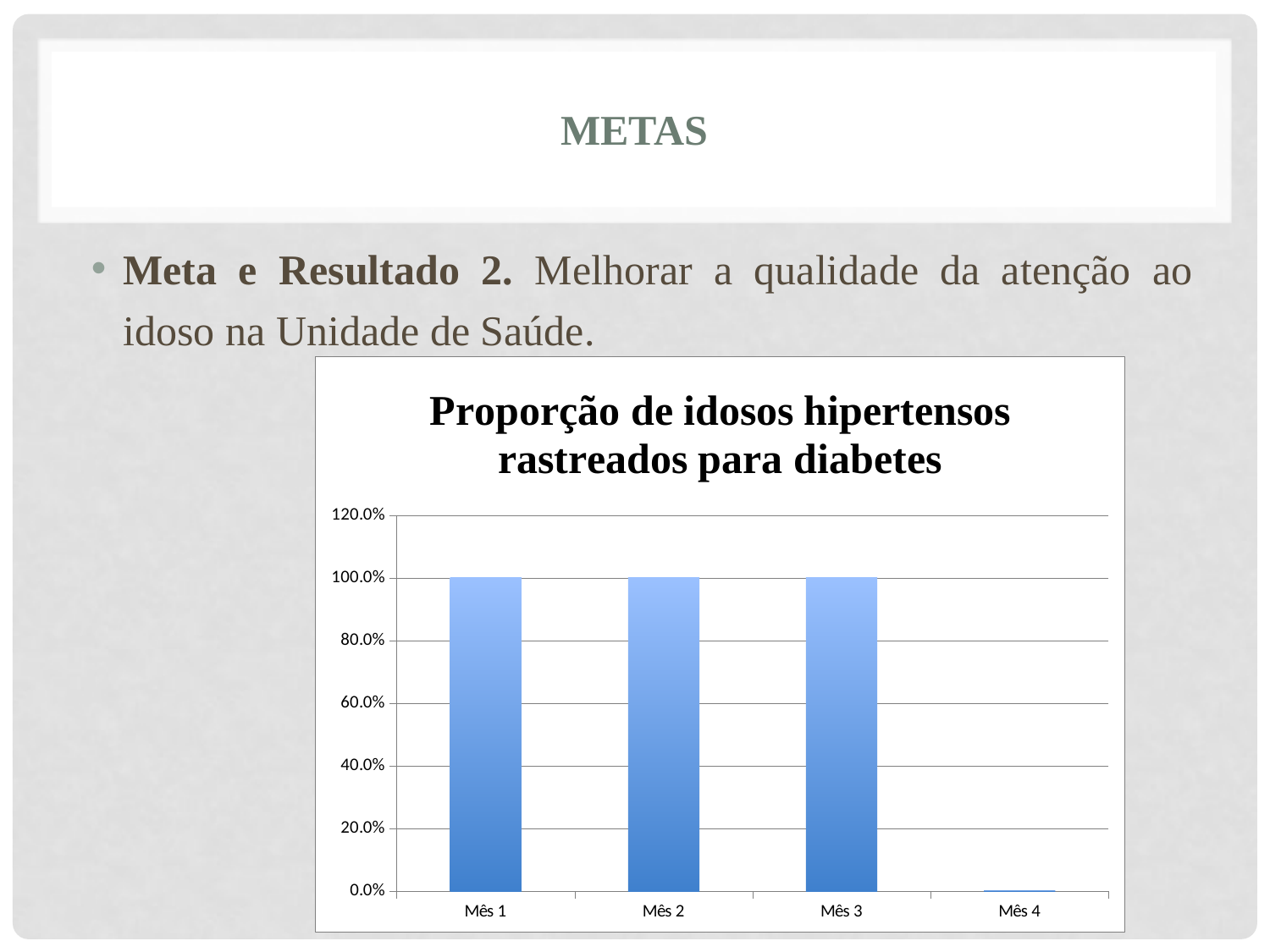
Which month has the lowest value? Mês 4 How many categories (months) are shown on the x axis of the chart? 4 Is the value for Mês 4 greater or less than 20.0%? less Which is larger, the value for Mês 3 or the value for Mês 4? Mês 3 Is the value for Mês 2 greater or less than 80.0%? greater What is the title of the chart? Proporção de idosos hipertensos rastreados para diabetes What is the value for Mês 3? 100.0% What is the highest value shown on the y axis of the chart? 120.0% What type of chart is shown on the slide? bar chart What is the value for Mês 1? 100.0% What is the value for Mês 2? 100.0% Do the values rise or fall from Mês 3 to Mês 4? fall